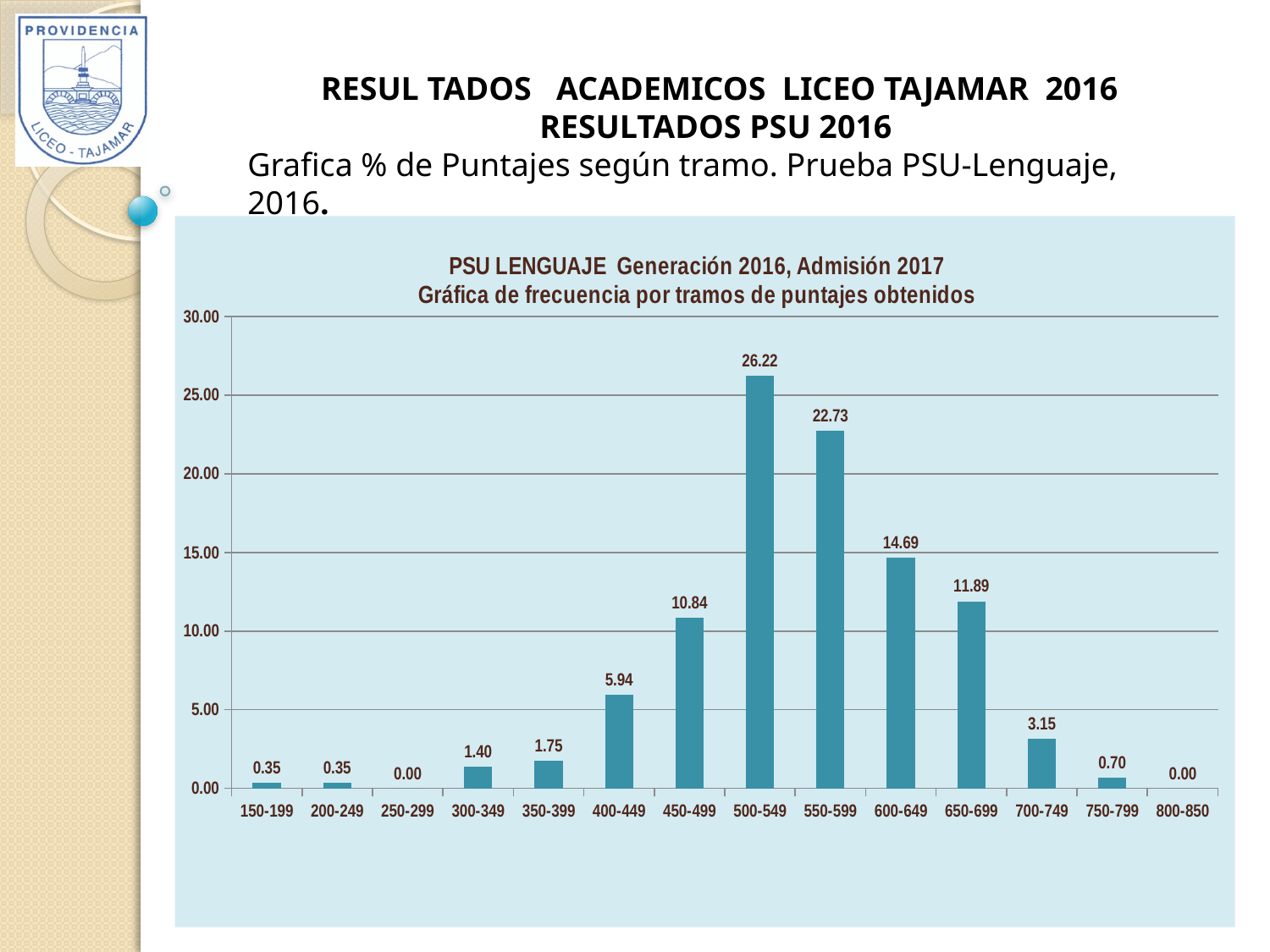
Which score range has the highest value? 500-549 What is the difference between the values for 500-549 and 550-599? 3.49 What is the value for the 500-549 score range? 26.22 What is the value for the 600-649 score range? 14.69 What is the title of the chart? PSU LENGUAJE Generación 2016, Admisión 2017 Gráfica de frecuencia por tramos de puntajes obtenidos Which is larger, the value for 650-699 or the value for 450-499? 650-699 Which score ranges have a value of 0.00? 250-299 and 800-850 What is the value for the 400-449 score range? 5.94 Do the values rise or fall from 500-549 to 800-850? Fall What is the value for the 750-799 score range? 0.70 How many score ranges are shown on the x axis? 14 What kind of chart is this? Bar chart